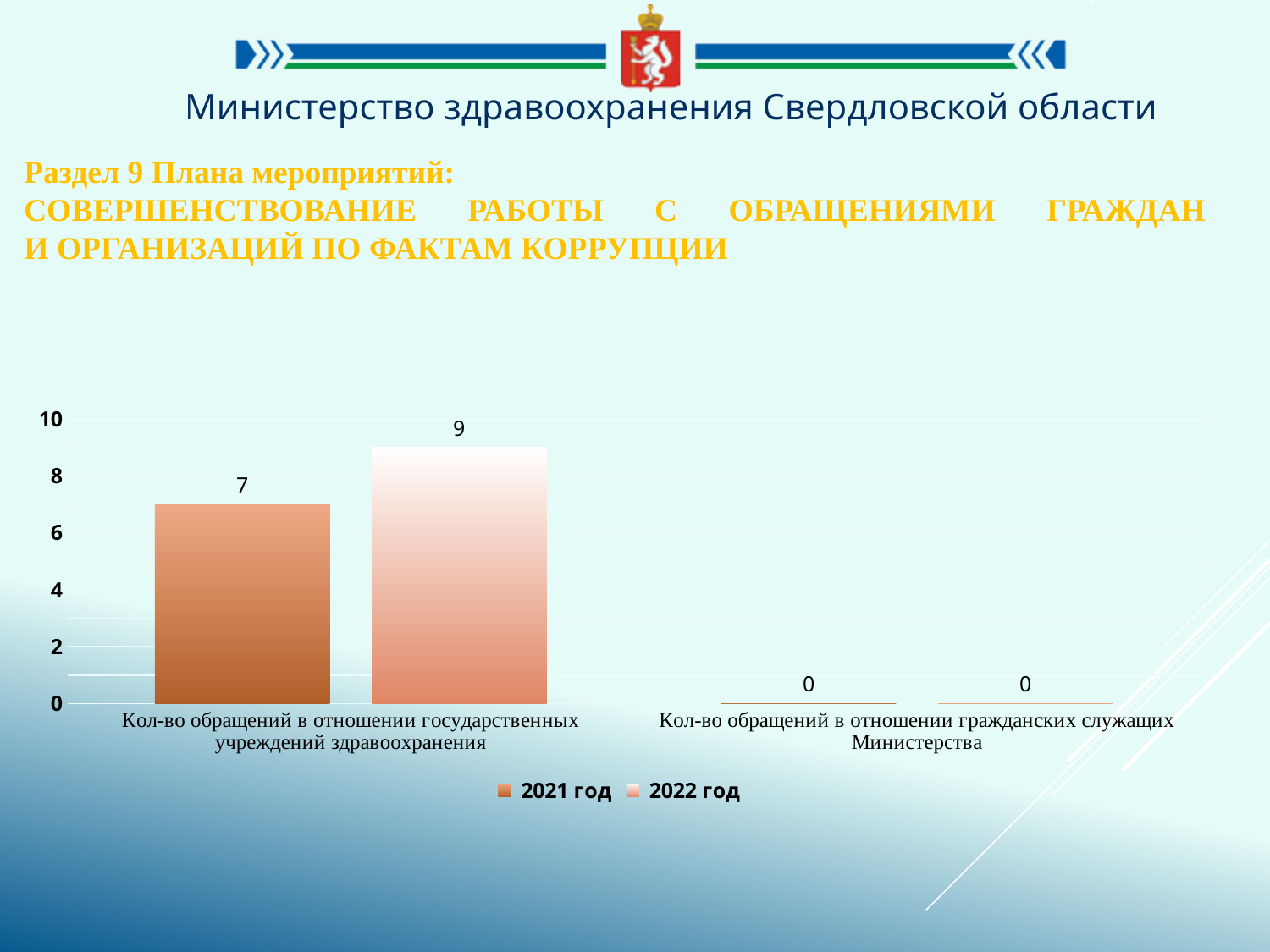
Which category has the highest value in the chart? Кол-во обращений в отношении государственных учреждений здравоохранения How many series does the legend list? 2 What is the value for 2021 год for 'Кол-во обращений в отношении государственных учреждений здравоохранения'? 7 What is the value for 2022 год for 'Кол-во обращений в отношении гражданских служащих Министерства'? 0 How many categories are shown on the x axis of the chart? 2 Which series has the higher value for 'Кол-во обращений в отношении государственных учреждений здравоохранения', 2021 год or 2022 год? 2022 год What is the value for 2021 год for 'Кол-во обращений в отношении гражданских служащих Министерства'? 0 Is the 2022 год value for 'Кол-во обращений в отношении государственных учреждений здравоохранения' greater or less than 8? greater What is the value for 2022 год for 'Кол-во обращений в отношении государственных учреждений здравоохранения'? 9 What is the difference between the 2022 год and 2021 год values for 'Кол-во обращений в отношении государственных учреждений здравоохранения'? 2 What kind of chart is shown on the slide? bar chart What are the two series listed in the legend? 2021 год and 2022 год